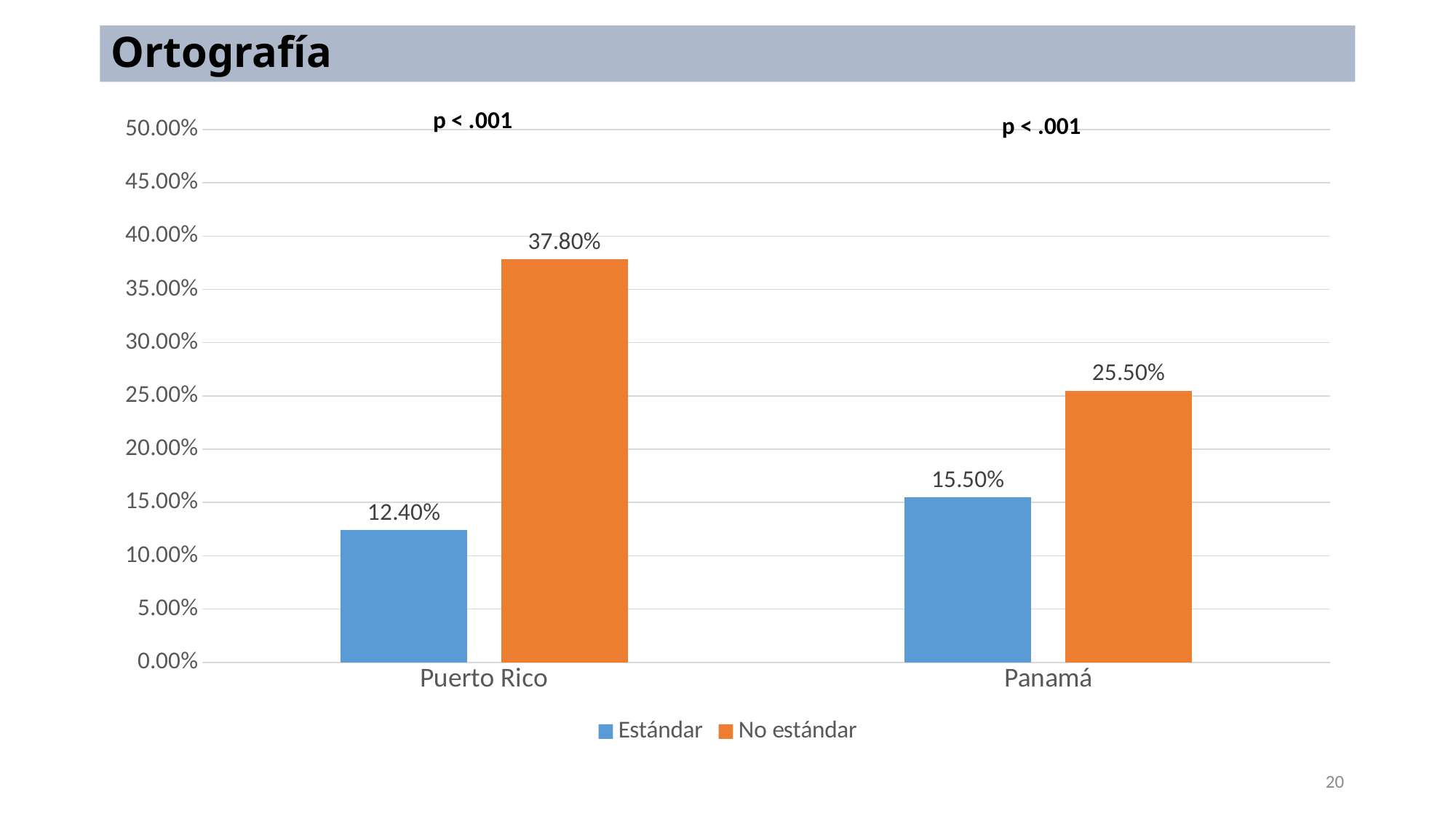
What is the difference between No estándar and Estándar in Panamá? 10.00% How many categories are shown on the x axis? 2 Which is larger: Estándar in Panamá or Estándar in Puerto Rico? Estándar in Panamá What is the value for Estándar in Puerto Rico? 12.40% What is the value for No estándar in Panamá? 25.50% Which bar has the highest value on the chart? No estándar, Puerto Rico Which bar has the lowest value on the chart? Estándar, Puerto Rico What kind of chart is shown on the slide? Bar chart What is the value for No estándar in Puerto Rico? 37.80% How many series does the legend list? 2 What is the difference between No estándar and Estándar in Puerto Rico? 25.40% What is the value for Estándar in Panamá? 15.50%